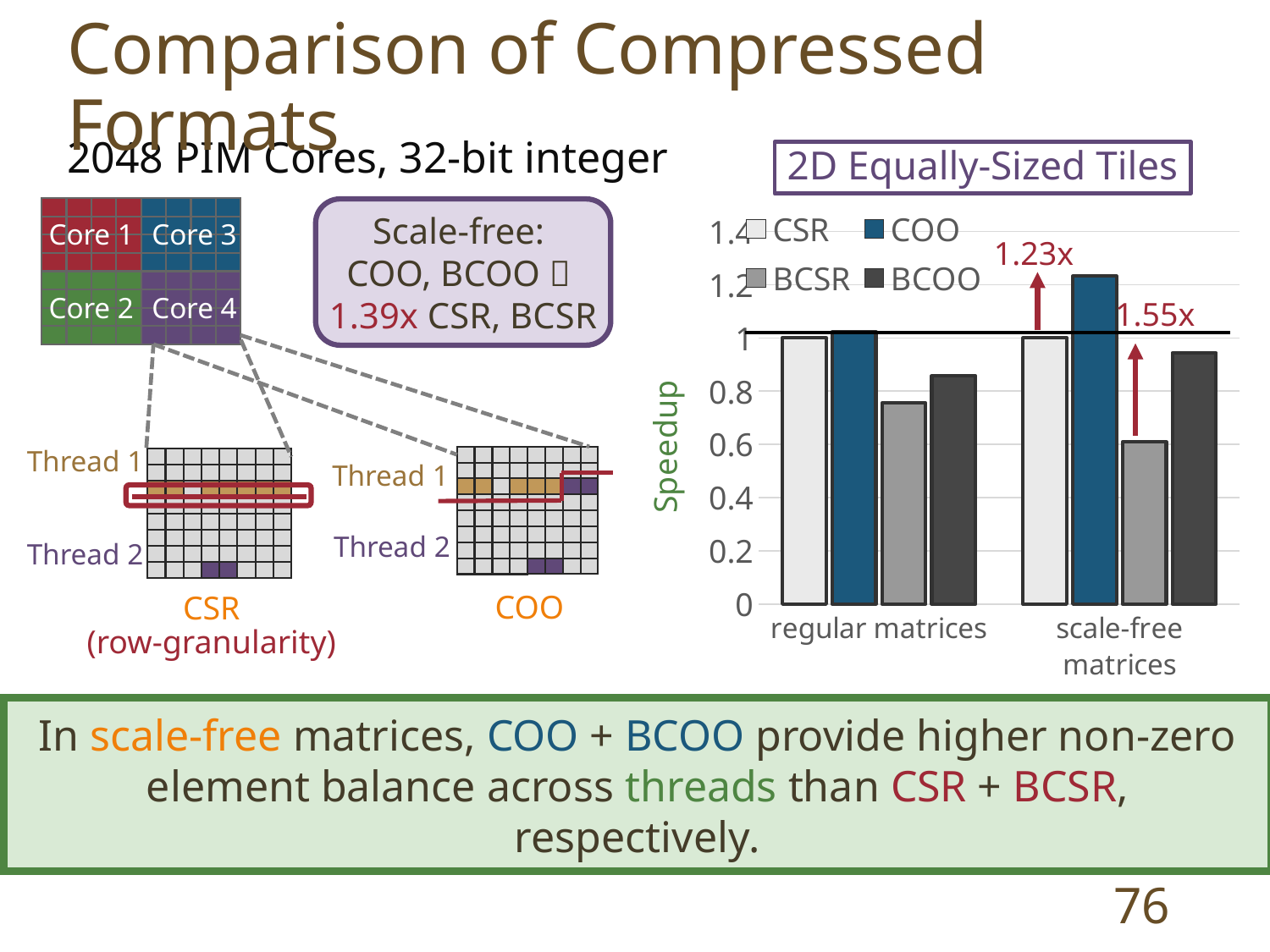
In the '2D Equally-Sized Tiles' chart, which format has the lowest speedup for scale-free matrices? BCSR What kind of chart is shown under the title '2D Equally-Sized Tiles'? bar chart What is the title of the bar chart on the slide? 2D Equally-Sized Tiles In the '2D Equally-Sized Tiles' chart, which is larger for regular matrices: the speedup of COO or of BCSR? COO What is the label of the y axis of the '2D Equally-Sized Tiles' chart? Speedup How many series does the legend of the '2D Equally-Sized Tiles' chart list? 4 In the '2D Equally-Sized Tiles' chart, what speedup factor is annotated above the COO bar for scale-free matrices? 1.23x In the '2D Equally-Sized Tiles' chart, what speedup factor is annotated above the BCSR bar for scale-free matrices? 1.55x In the '2D Equally-Sized Tiles' chart, which format has the highest speedup for scale-free matrices? COO In the '2D Equally-Sized Tiles' chart, is the speedup of BCSR for scale-free matrices greater or less than 0.8? less How many categories are shown on the x axis of the '2D Equally-Sized Tiles' chart? 2 In the '2D Equally-Sized Tiles' chart, what is the speedup of CSR for regular matrices? 1